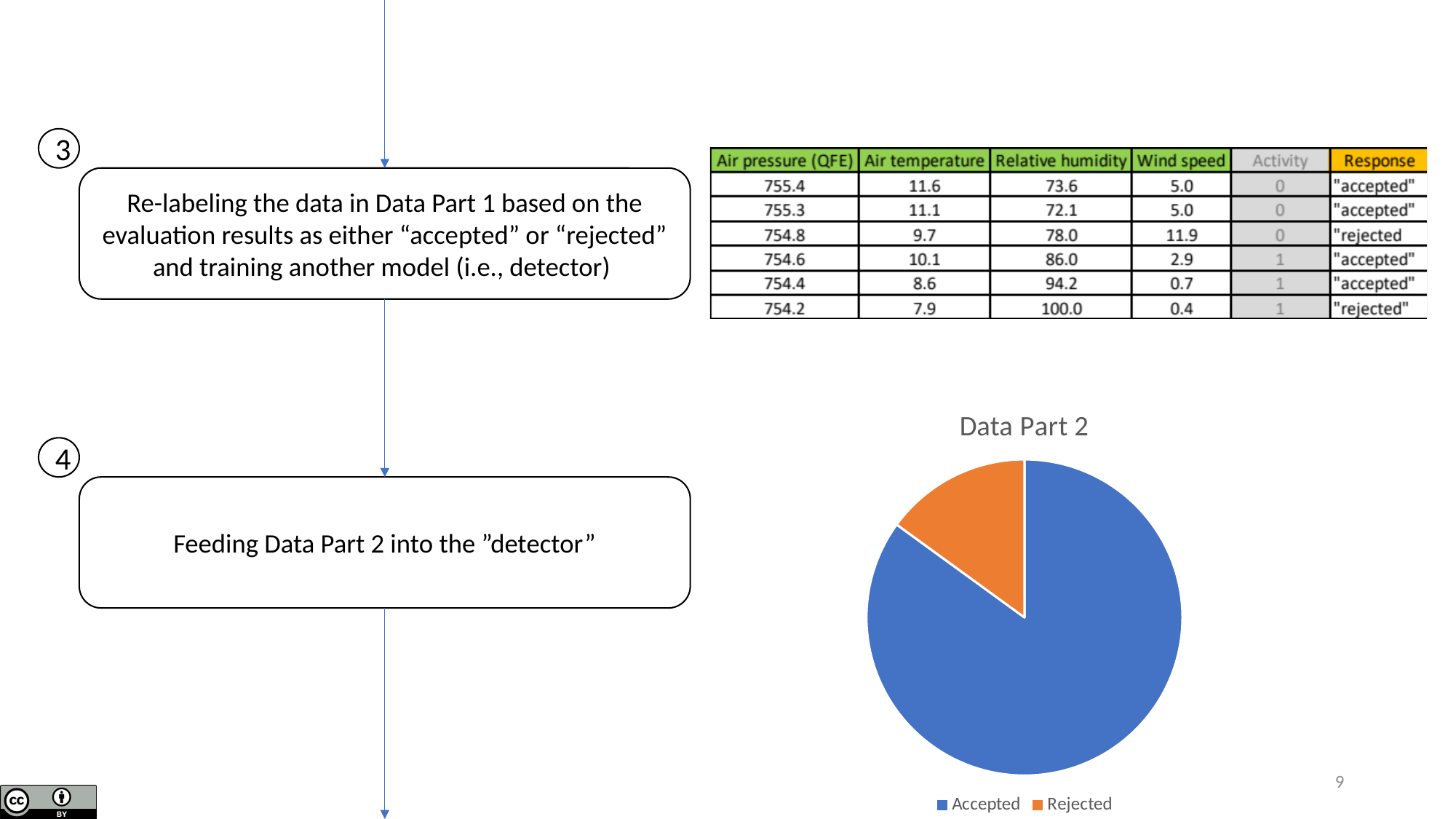
In the "Data Part 2" pie chart, which category has the smallest slice? Rejected In the "Data Part 2" pie chart, which is larger: the Accepted slice or the Rejected slice? Accepted How many slices does the "Data Part 2" pie chart have? 2 What is the title of the pie chart on the slide? Data Part 2 What kind of chart is shown under the title "Data Part 2"? pie chart In the "Data Part 2" pie chart, what colour is the Rejected slice? orange In the "Data Part 2" pie chart, which category has the largest slice? Accepted How many entries does the legend of the "Data Part 2" pie chart list? 2